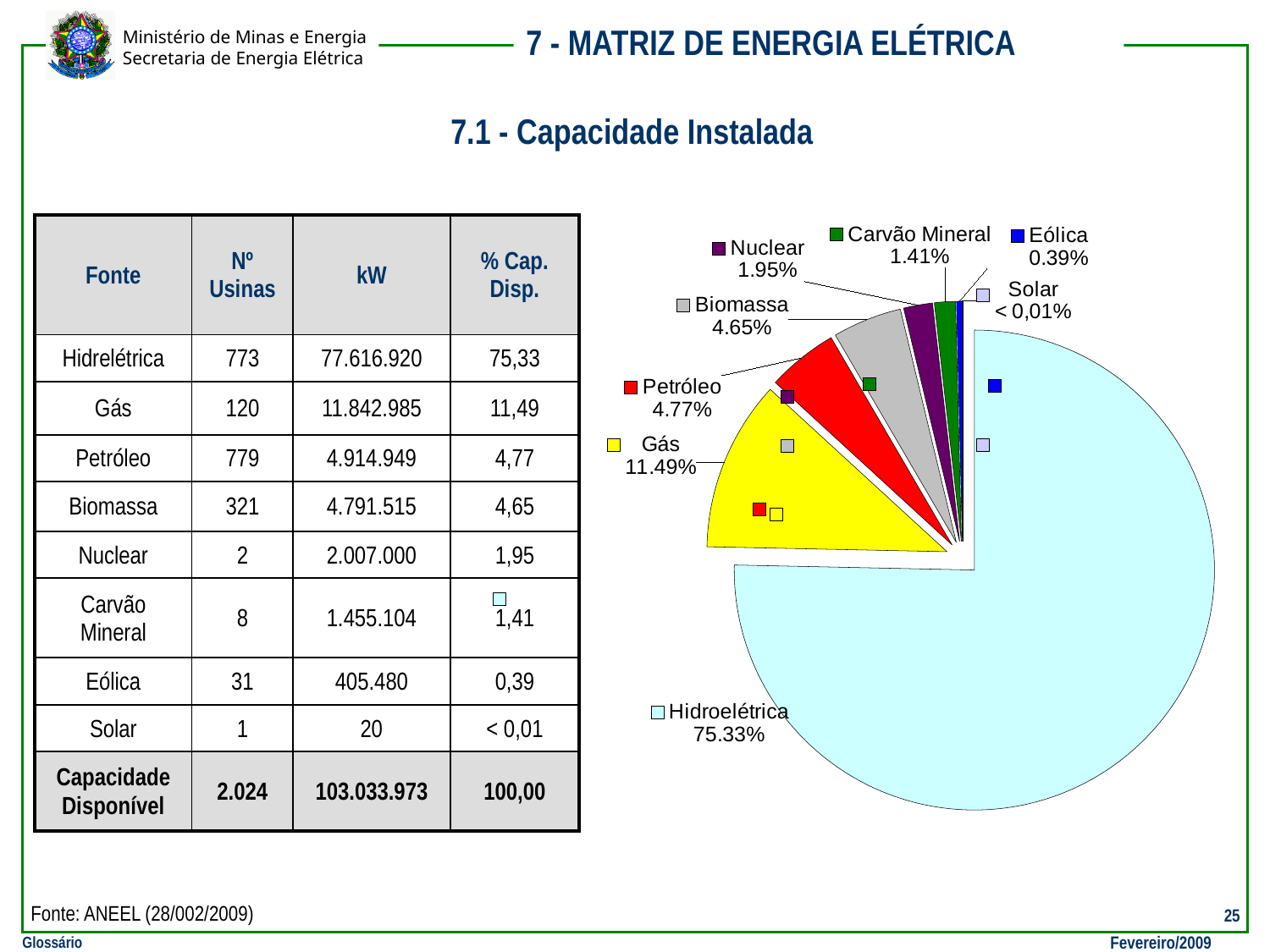
How many slices does the pie chart have? 8 What share of the pie does Hidroelétrica have? 75.33% What share of the pie does Gás have? 11.49% What share of the pie does Biomassa have? 4.65% Which slice of the pie chart is the largest? Hidroelétrica Which is larger in the pie chart, Gás or Petróleo? Gás Which slice of the pie chart is the smallest? Solar What kind of chart is shown on the slide? pie chart What share of the pie does Nuclear have? 1.95% What share of the pie does Eólica have? 0.39% What is the difference between the Gás share and the Petróleo share in the pie chart? 6.72% What share of the pie does Petróleo have? 4.77%